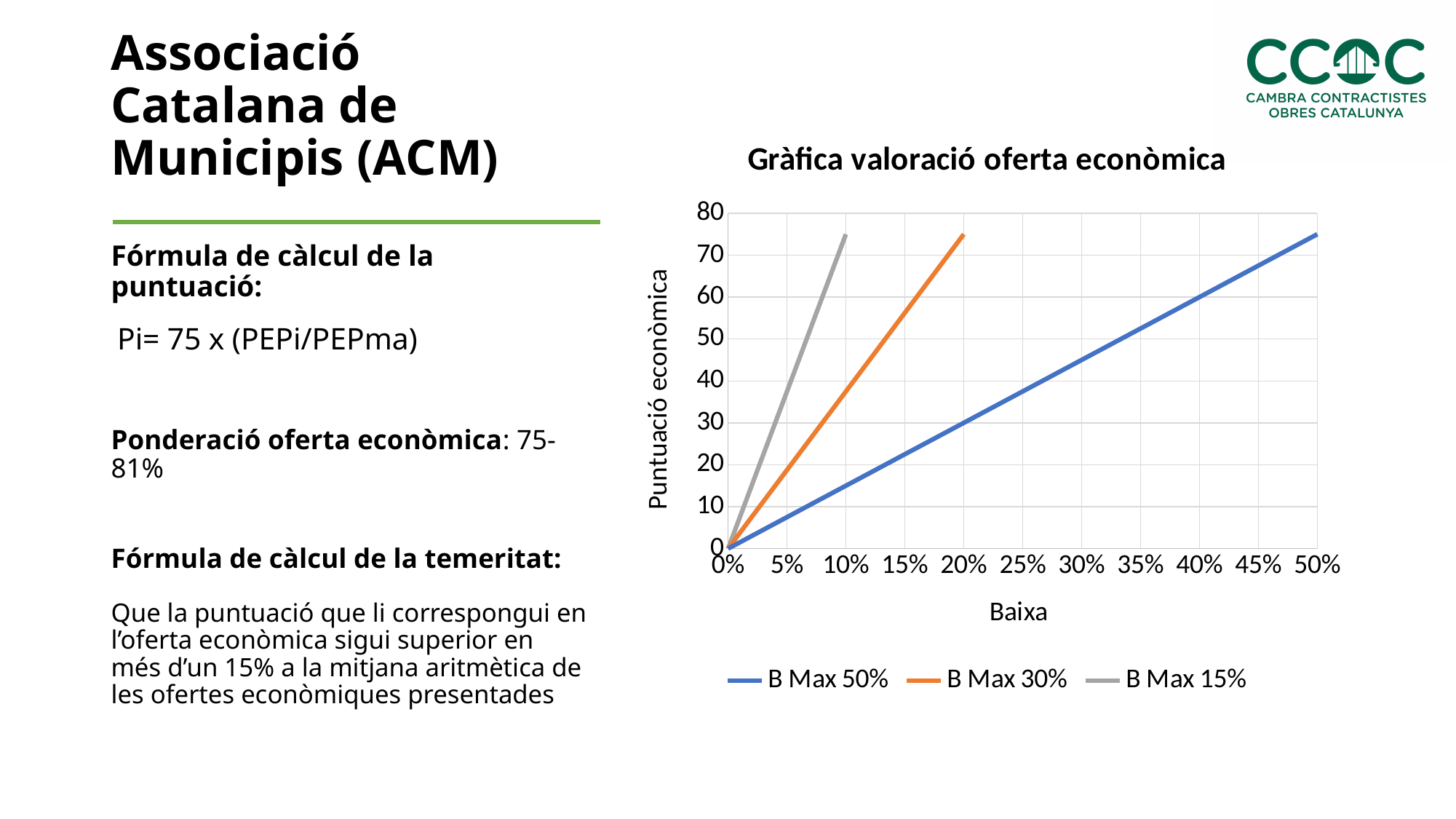
Do the values of the B Max 50% series rise or fall as Baixa increases? rise How many series does the legend of the chart list? 3 What kind of chart is shown on the slide? line chart Is the value of the B Max 30% series at a Baixa of 15% greater or less than 50? greater What is the label of the vertical axis of the chart? Puntuació econòmica Is the value of the B Max 50% series at a Baixa of 10% greater or less than 20? less Is the value of the B Max 15% series at a Baixa of 10% greater or less than 70? greater At a Baixa of 10%, which series has the higher value, B Max 15% or B Max 50%? B Max 15% Which series has the steepest line in the chart? B Max 15% What is the title of the chart? Gràfica valoració oferta econòmica Which series extends furthest along the Baixa axis? B Max 50%